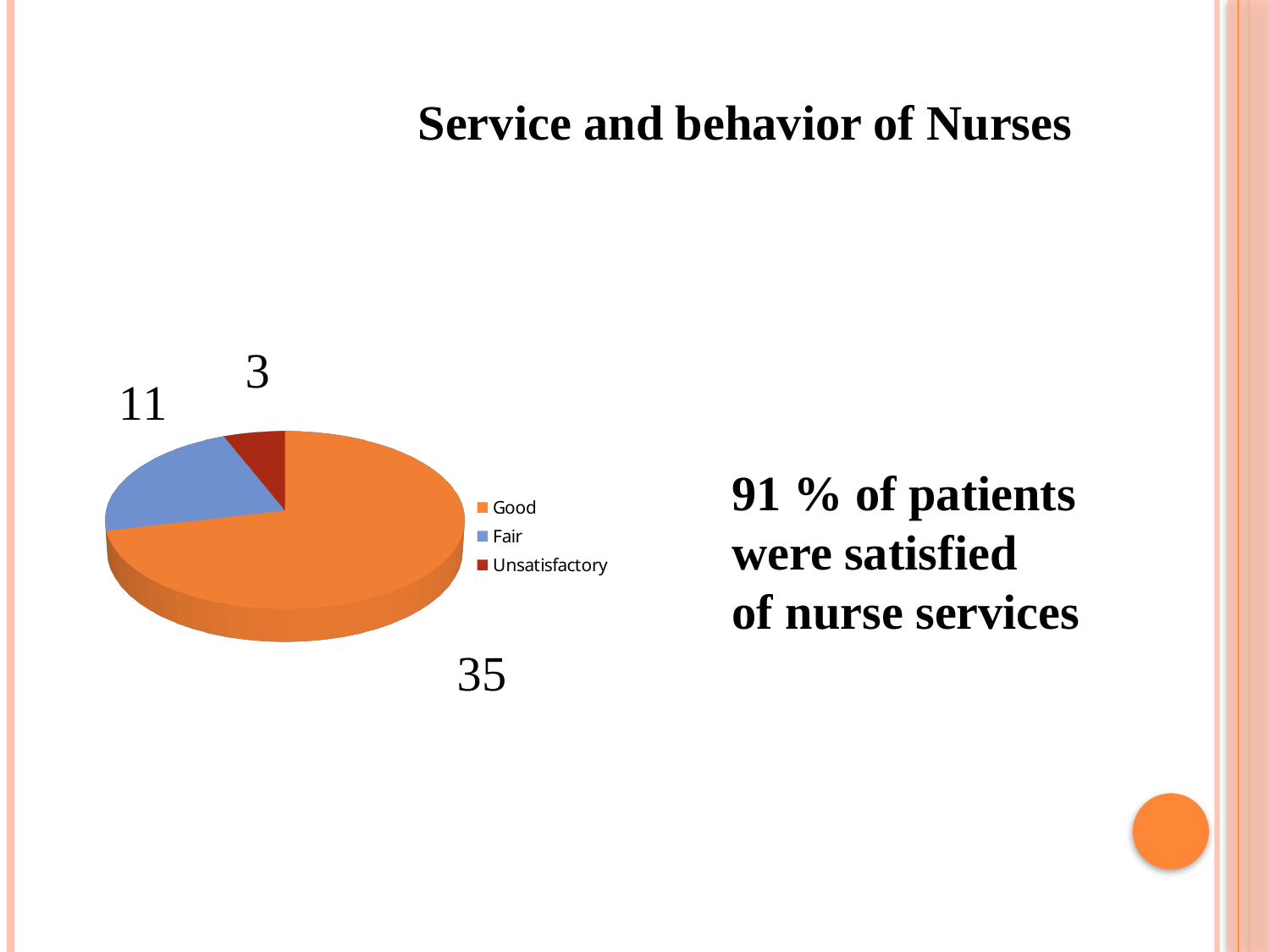
What is the value for Unsatisfactory in the pie chart? 3 How many categories does the pie chart have? 3 Which is larger, the value for Fair or the value for Unsatisfactory? Fair What kind of chart is shown on the slide? pie chart What is the value for Fair in the pie chart? 11 Which category has the largest slice in the pie chart? Good What is the difference between the Fair and Unsatisfactory values? 8 What is the total of all slices in the pie chart? 49 What is the value for Good in the pie chart? 35 What is the difference between the Good and Fair values? 24 What colour is the Fair slice in the pie chart? blue Which category has the smallest slice in the pie chart? Unsatisfactory